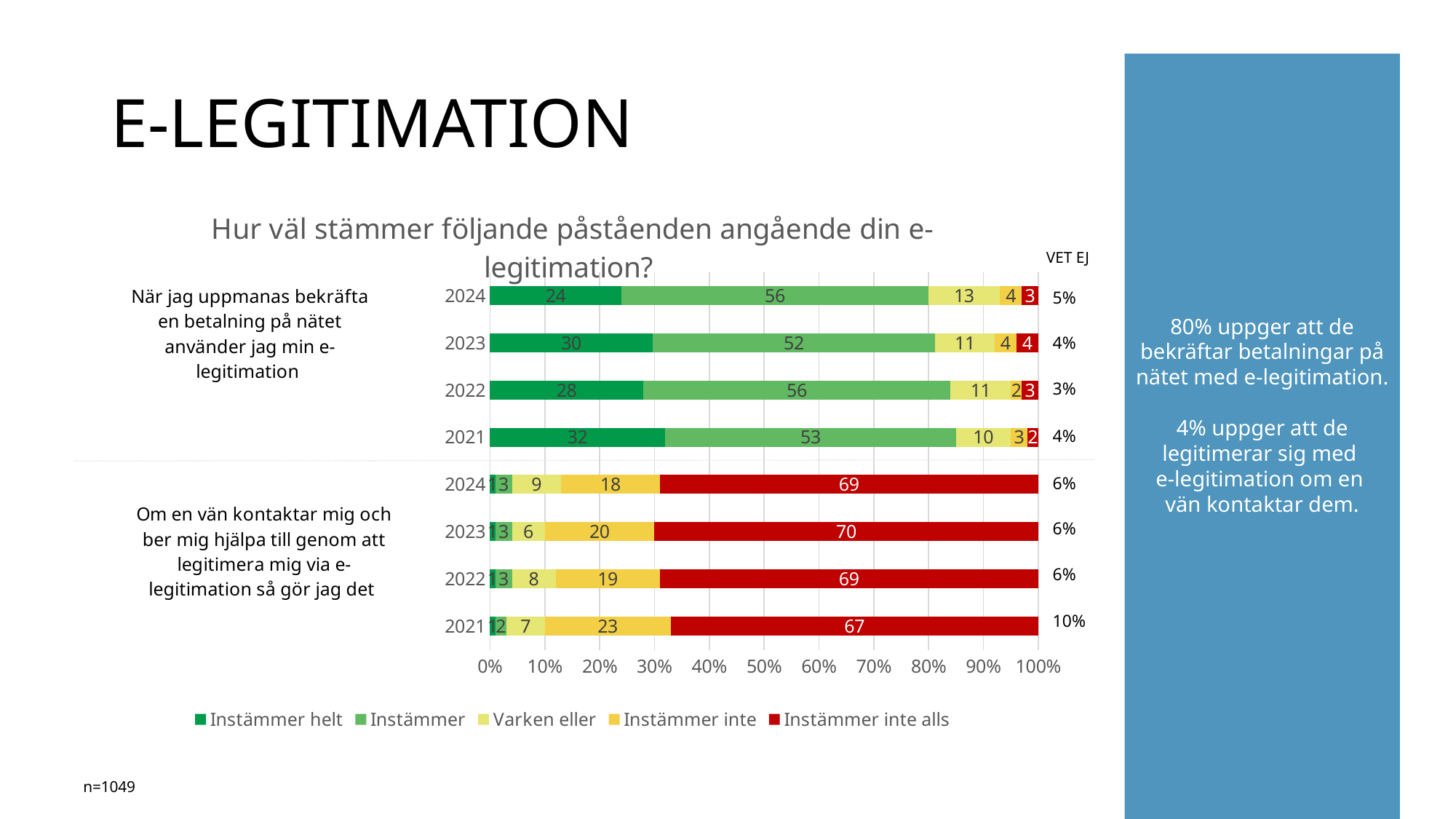
For the statement about confirming payments online, what is the difference between the "Instämmer" values for 2024 and 2023? 4 For the statement about helping a friend legitimize, which year has the lowest "Instämmer inte alls" value? 2021 What is the "VET EJ" percentage shown for 2021 for the statement about helping a friend legitimize? 10% For the statement "När jag uppmanas bekräfta en betalning på nätet använder jag min e-legitimation", what is the value of "Instämmer helt" in 2024? 24 For the statement "Om en vän kontaktar mig och ber mig hjälpa till genom att legitimera mig via e-legitimation så gör jag det", what is the value of "Instämmer inte alls" in 2023? 70 For the statement about confirming payments online in 2024, what is the combined value of "Instämmer helt" and "Instämmer"? 80 For the statement about confirming payments online, which year has the highest "Instämmer helt" value? 2021 What kind of chart is shown on the slide? Stacked bar chart How many series does the chart legend list? 5 For the statement about helping a friend legitimize, what is the value of "Varken eller" in 2022? 8 How many bars are plotted in the chart in total? 8 For the statement about helping a friend legitimize, which year has the larger "Instämmer inte" value, 2021 or 2024? 2021